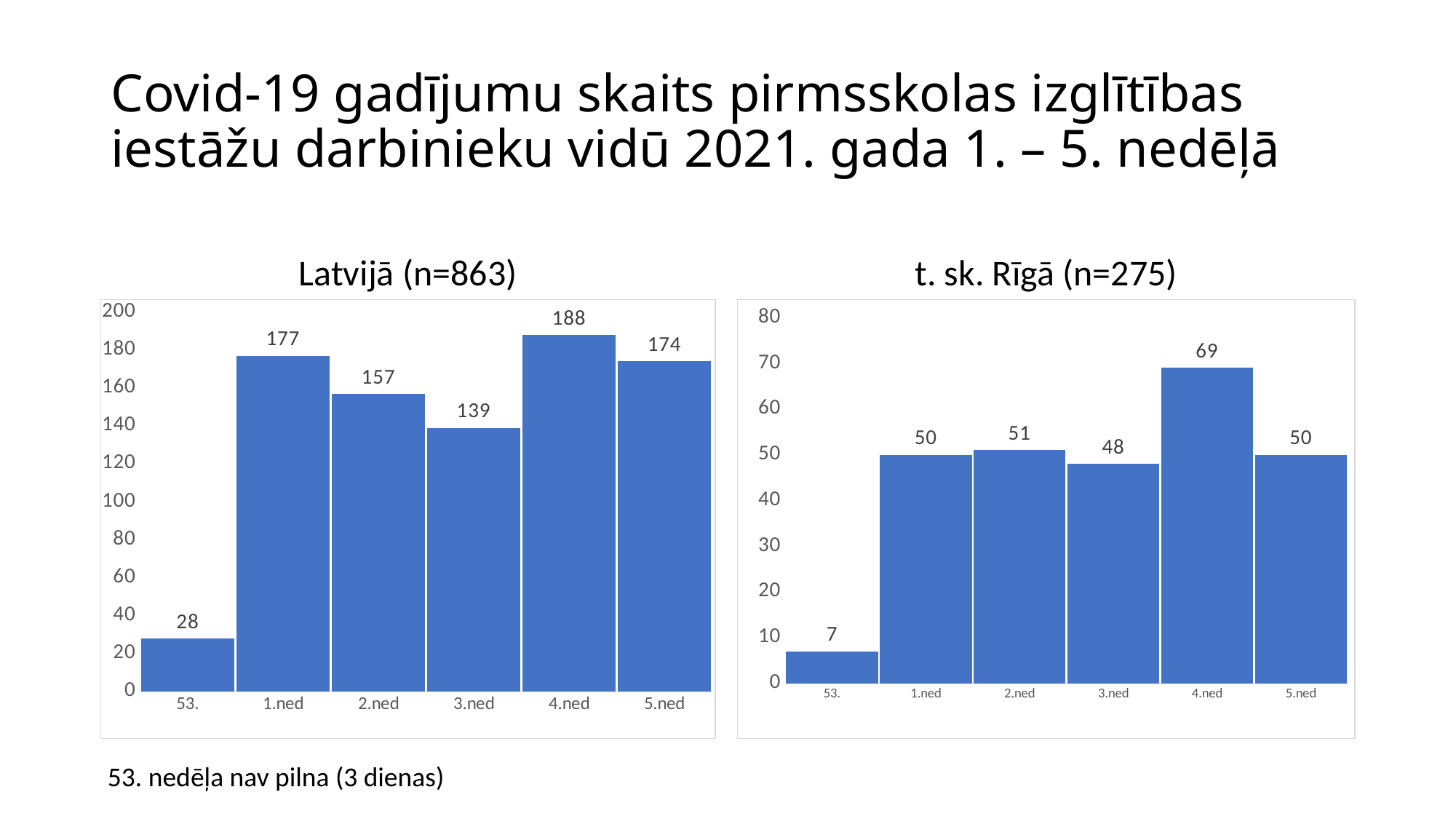
In the 't. sk. Rīgā (n=275)' chart, is the value for 2.ned greater or less than 40? greater In the 'Latvijā (n=863)' chart, which category has the lowest value? 53. In the 'Latvijā (n=863)' chart, what is the difference between the values for 1.ned and 3.ned? 38 What is the title of the chart on the right side of the slide? t. sk. Rīgā (n=275) In the 'Latvijā (n=863)' chart, what is the value for 4.ned? 188 How many categories are shown in the 'Latvijā (n=863)' chart? 6 In the 't. sk. Rīgā (n=275)' chart, what is the value for 3.ned? 48 In the 't. sk. Rīgā (n=275)' chart, which category has the highest value? 4.ned In the 'Latvijā (n=863)' chart, does the value rise or fall from 4.ned to 5.ned? fall What kind of chart is the 't. sk. Rīgā (n=275)' chart? bar chart In the 'Latvijā (n=863)' chart, which is larger, the value for 2.ned or the value for 5.ned? 5.ned In the 't. sk. Rīgā (n=275)' chart, what is the difference between the values for 4.ned and 53.? 62